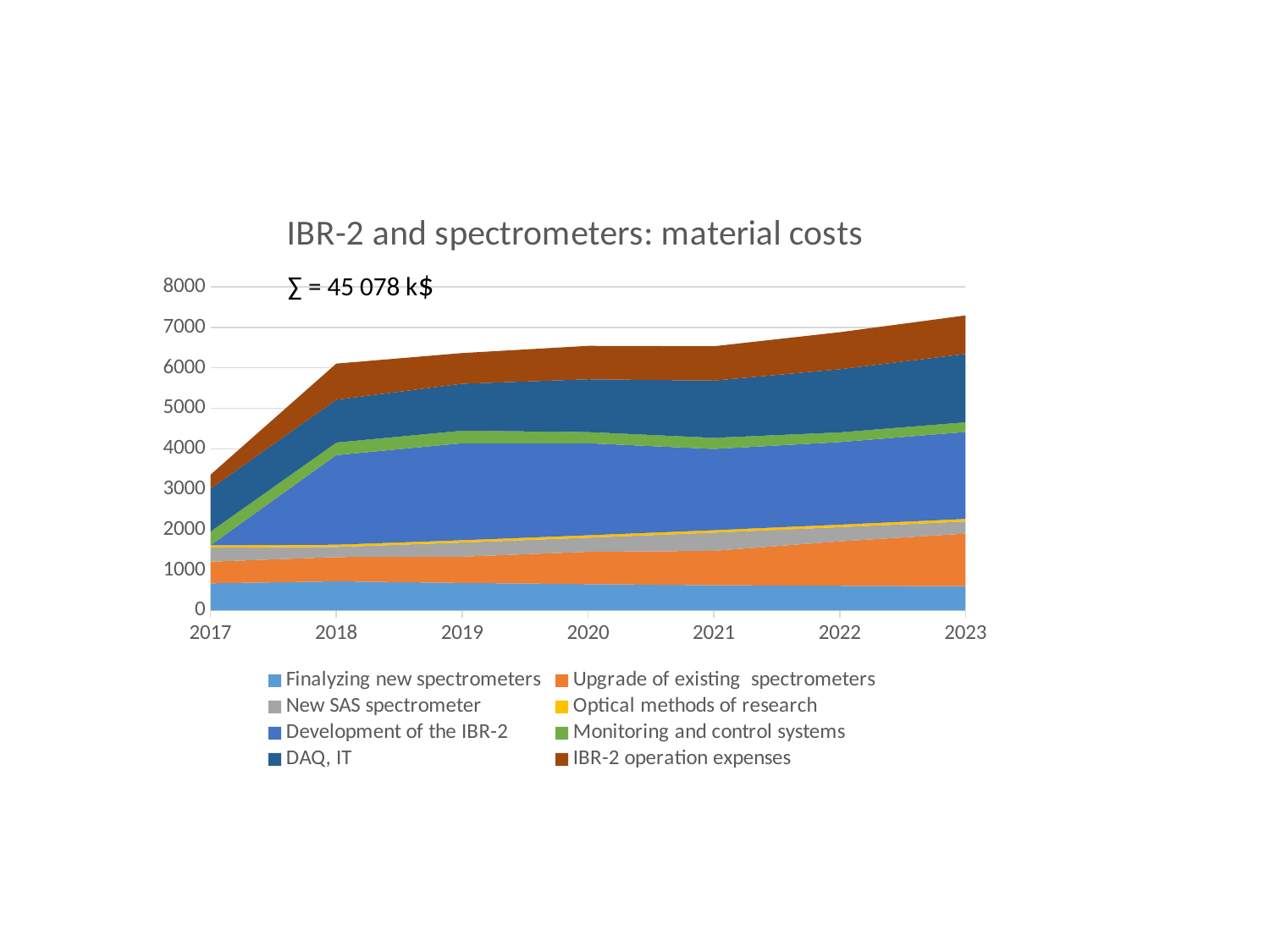
Is the total material cost in 2023 greater or less than 7000? greater Which year has the highest total material costs? 2023 What is the title of the chart? IBR-2 and spectrometers: material costs What total sum is annotated on the chart? ∑ = 45 078 k$ How many years are shown along the x axis? 7 Which year has the lowest total material costs? 2017 How many series does the legend list? 8 Which year has the larger total material cost, 2017 or 2023? 2023 Is the total material cost in 2017 greater or less than 4000? less Is the total material cost in 2020 greater or less than 6000? greater Do the total material costs rise or fall from 2017 to 2023? rise What kind of chart is shown on the slide? stacked area chart